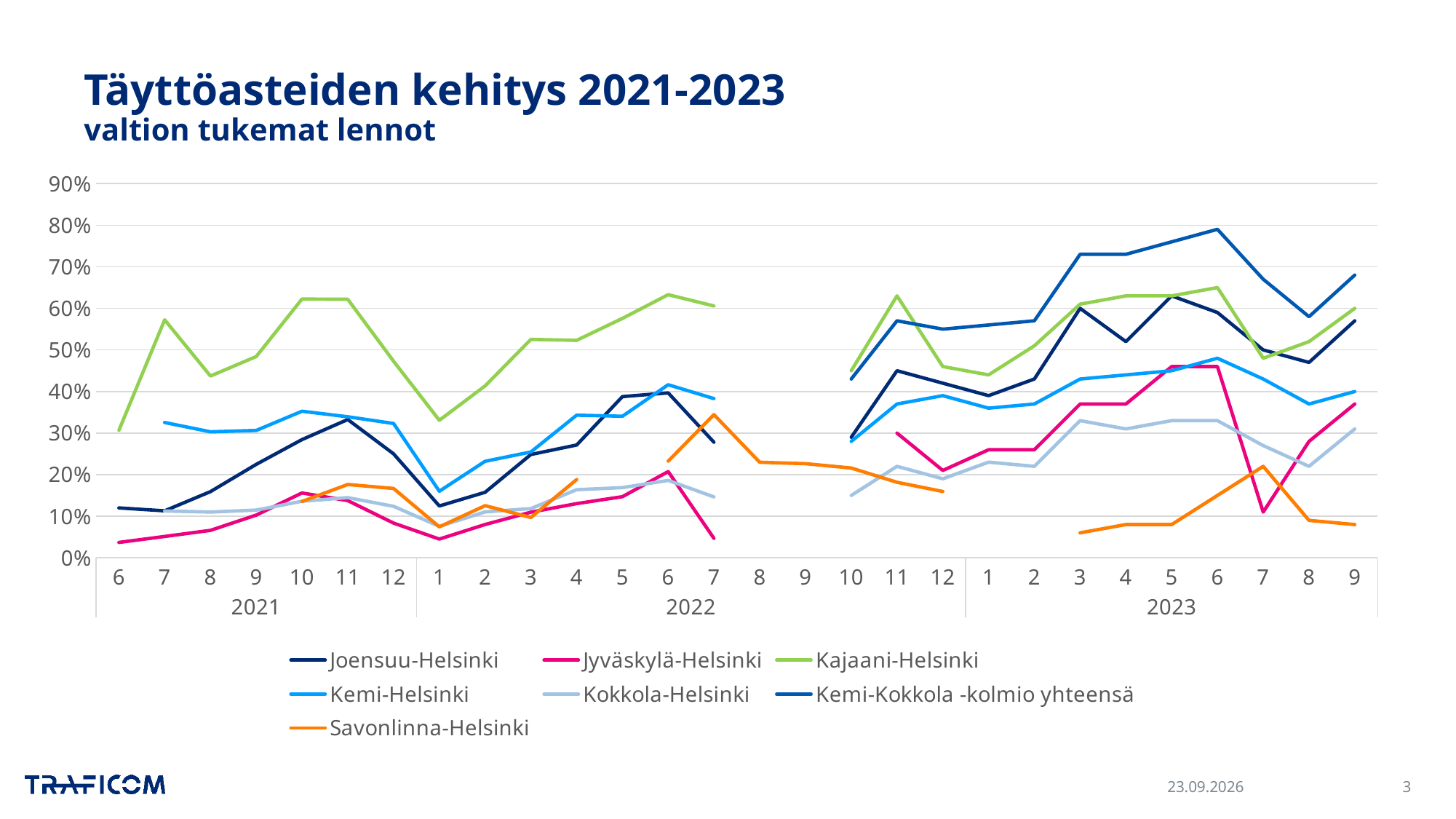
Is the value for Kajaani-Helsinki in month 10 of 2021 greater or less than 50%? greater What kind of chart is shown on the slide? Line chart Is the value for Kajaani-Helsinki in month 6 of 2021 greater or less than 40%? less Which series reaches the highest value anywhere on the chart? Kemi-Kokkola -kolmio yhteensä In month 6 of 2021, which series has the higher value: Kajaani-Helsinki or Jyväskylä-Helsinki? Kajaani-Helsinki How many series does the legend list? 7 What is the title of the chart? Täyttöasteiden kehitys 2021-2023 Is the value for Joensuu-Helsinki in month 1 of 2022 greater or less than 20%? less Does the Jyväskylä-Helsinki line rise or fall from month 6 to month 7 of 2023? fall Which years are labelled along the x axis? 2021, 2022, 2023